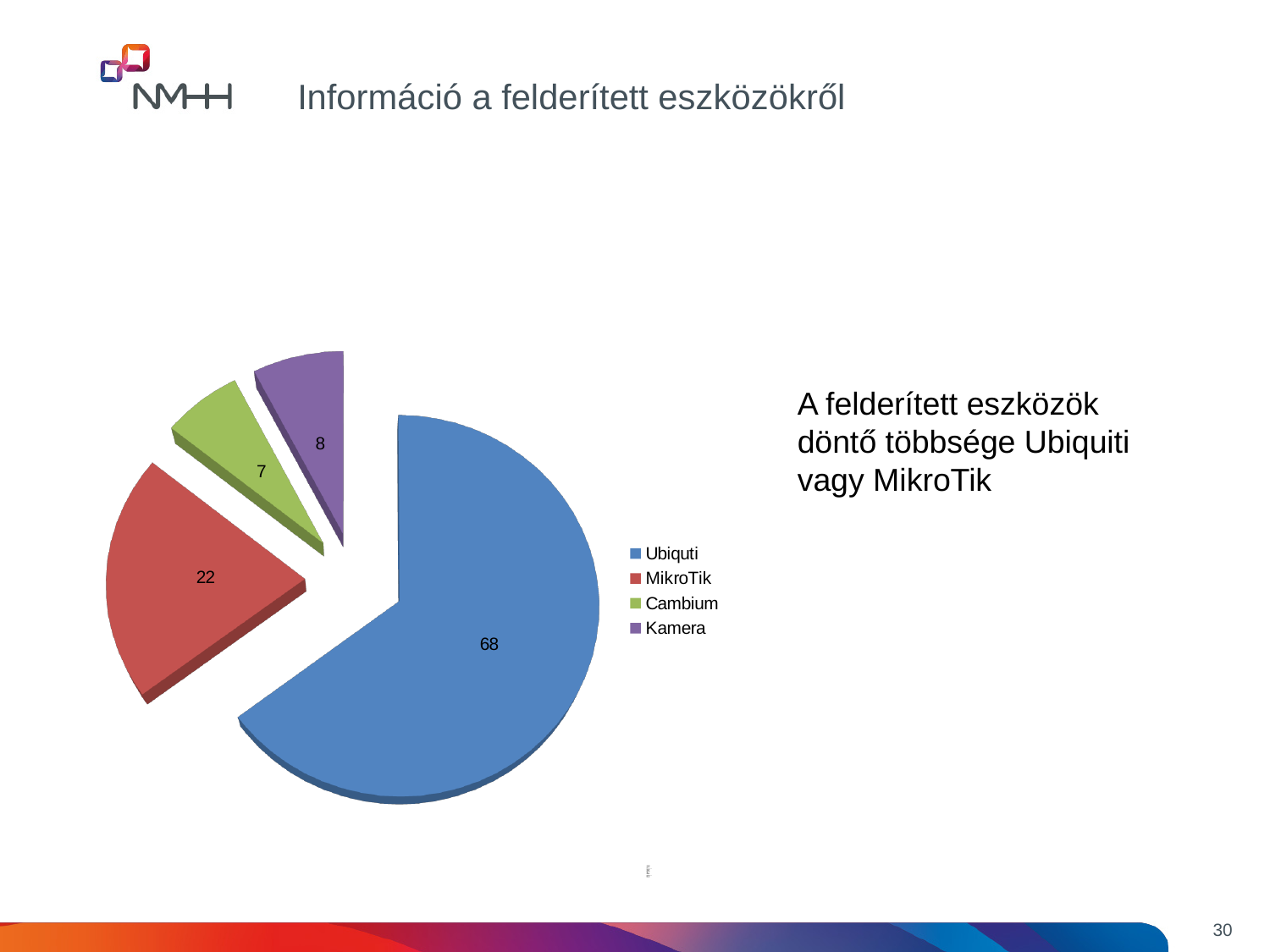
What is the value for Cambium in the pie chart? 7 What is the difference between the values for Ubiquti and MikroTik? 46 How many categories does the pie chart show? 4 Which category has the smallest slice in the pie chart? Cambium What is the value for Ubiquti in the pie chart? 68 What colour is the MikroTik slice in the pie chart? red Which is larger, the value for Kamera or the value for Cambium? Kamera What is the total of all the values shown in the pie chart? 105 What kind of chart is shown on the slide? pie chart What is the value for Kamera in the pie chart? 8 What is the value for MikroTik in the pie chart? 22 Which category has the largest slice in the pie chart? Ubiquti